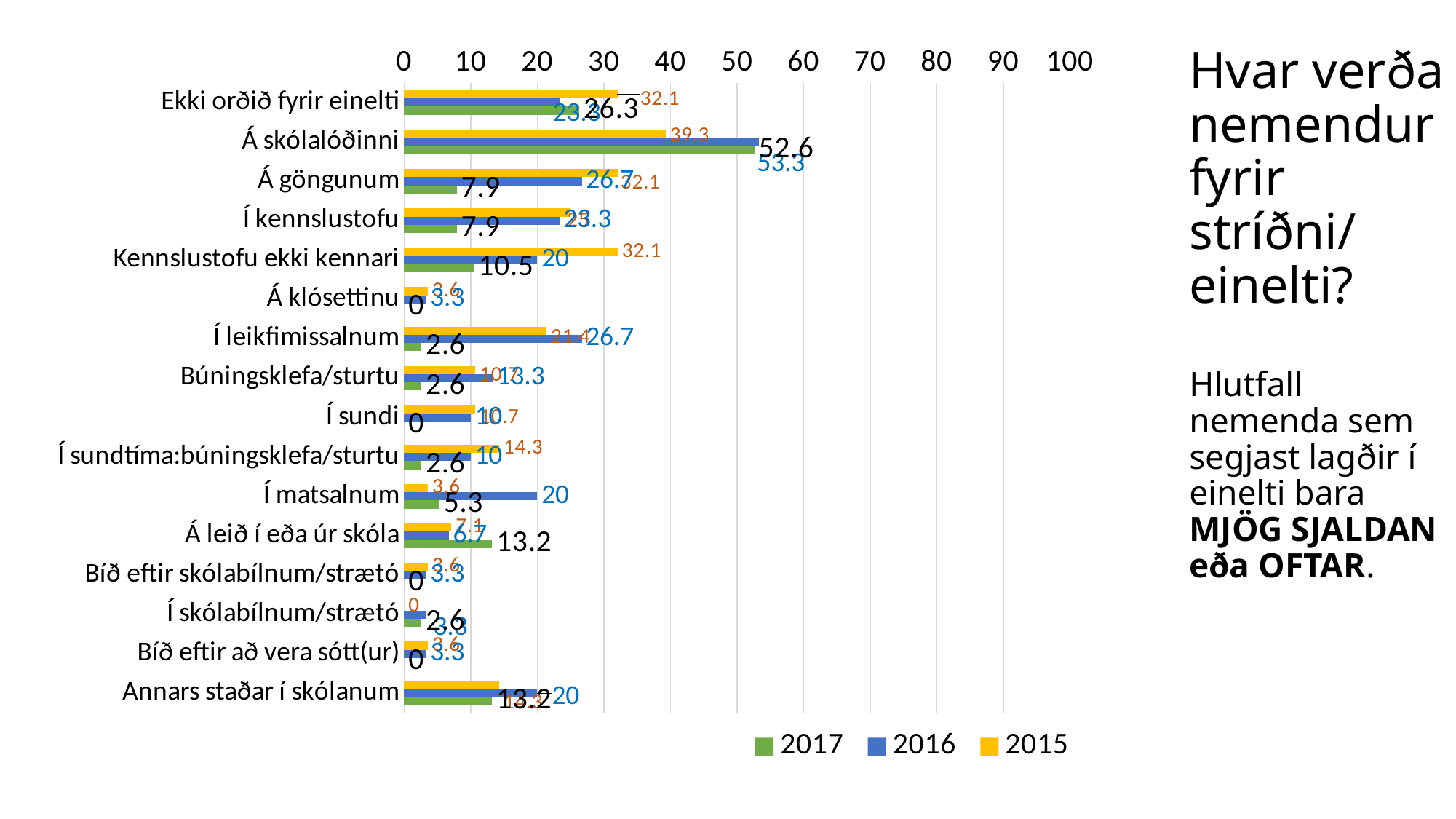
How many categories are shown on the chart? 16 What is the 2015 value for Kennslustofu ekki kennari? 32.1 Which category has the highest 2016 value? Á skólalóðinni What is the title of the chart? Hvar verða nemendur fyrir stríðni/einelti? Is the 2015 value for Á skólalóðinni greater or less than 30? greater Which is larger for Á göngunum, the 2016 value or the 2017 value? 2016 What kind of chart is shown on the slide? bar chart What is the 2017 value for Á leið í eða úr skóla? 13.2 What is the 2017 value for Á skólalóðinni? 52.6 What is the 2016 value for Á skólalóðinni? 53.3 What is the difference between the 2016 and 2017 values for Í matsalnum? 14.7 How many series does the legend list? 3